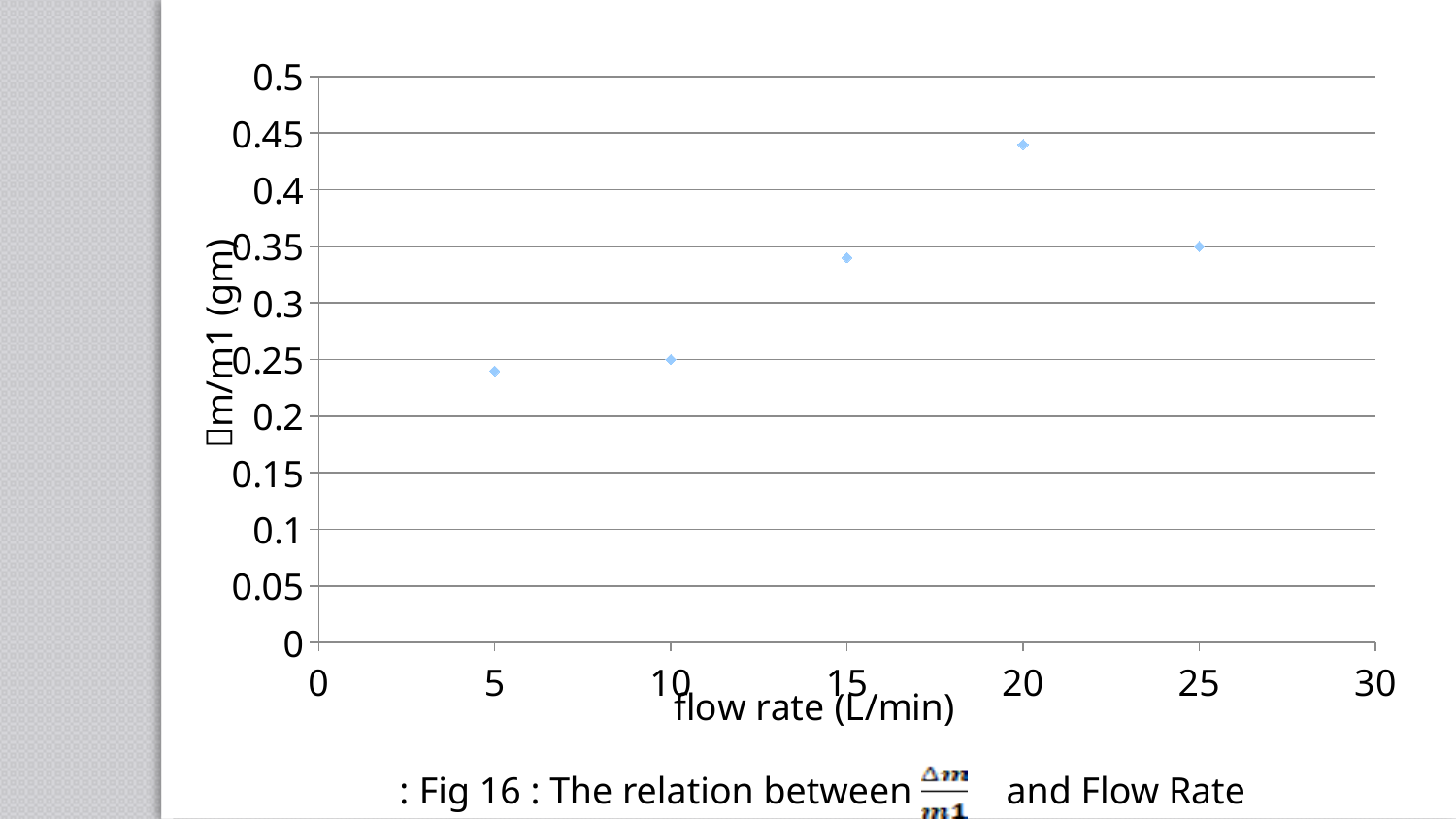
Is the value of Δm/m1 at a flow rate of 15 L/min greater or less than 0.3? greater Which has the larger Δm/m1 value: a flow rate of 5 L/min or 15 L/min? 15 L/min What kind of chart is shown on the slide? scatter chart Is the value of Δm/m1 at a flow rate of 25 L/min greater or less than 0.4? less What is the maximum value shown on the y axis? 0.5 Is the value of Δm/m1 at a flow rate of 20 L/min greater or less than 0.4? greater At which flow rate is Δm/m1 highest? 20 L/min How many data points are plotted on the chart? 5 Which has the larger Δm/m1 value: a flow rate of 20 L/min or 25 L/min? 20 L/min What is the label of the x axis? flow rate (L/min) Does Δm/m1 rise or fall as the flow rate increases from 5 to 20 L/min? rise